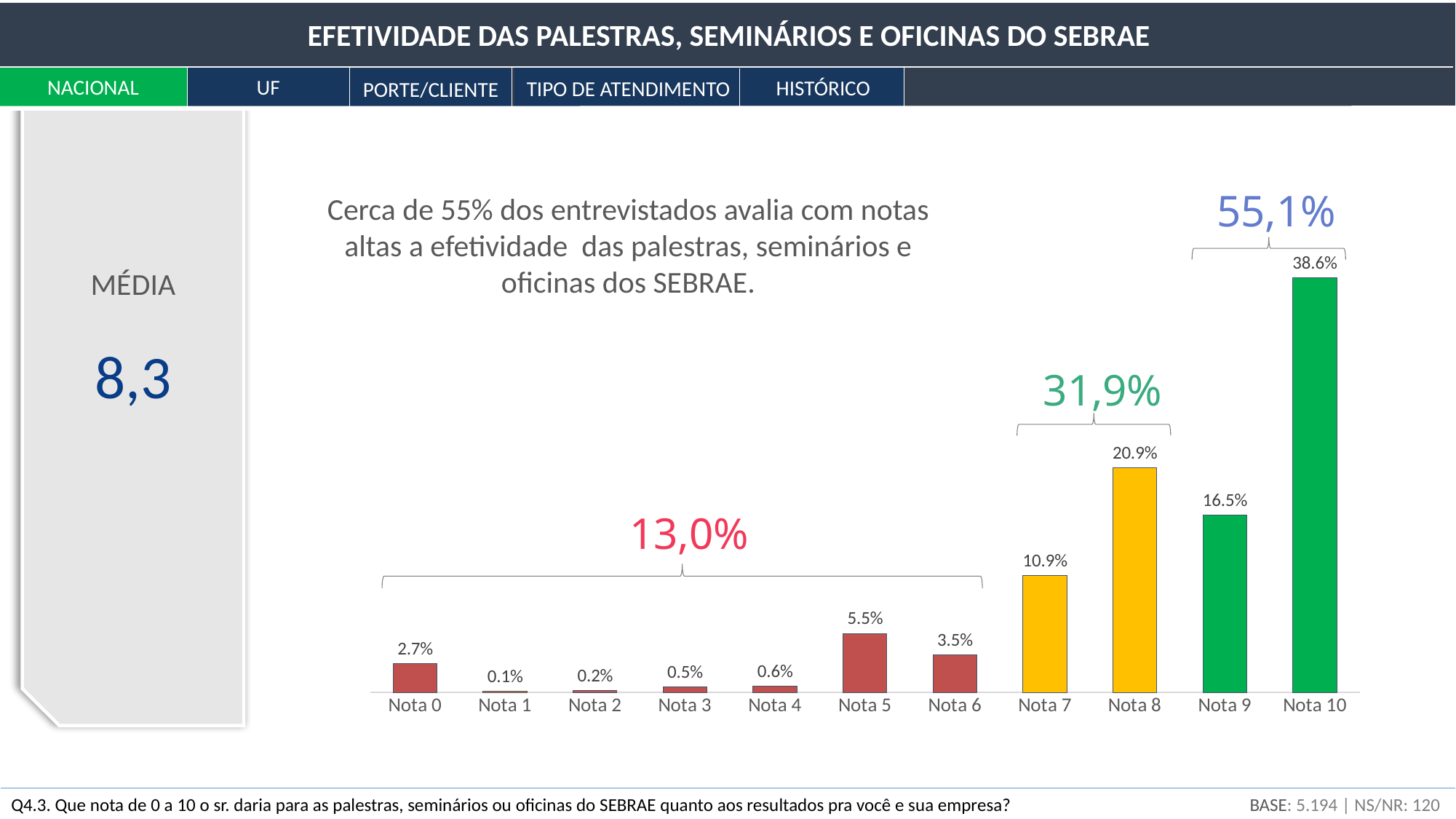
What is the difference between the values for Nota 8 and Nota 7? 10.0% What kind of chart is shown? bar chart What is the value for Nota 0? 2.7% Which category has the lowest value? Nota 1 What is the value for Nota 10? 38.6% What is the difference between the values for Nota 10 and Nota 9? 22.1% What percentage is shown above the bracket grouping Nota 7 and Nota 8? 31,9% How many categories are shown on the x axis? 11 Which is larger, the value for Nota 5 or the value for Nota 6? Nota 5 What is the value for Nota 5? 5.5% Which category has the highest value? Nota 10 What is the value for Nota 8? 20.9%